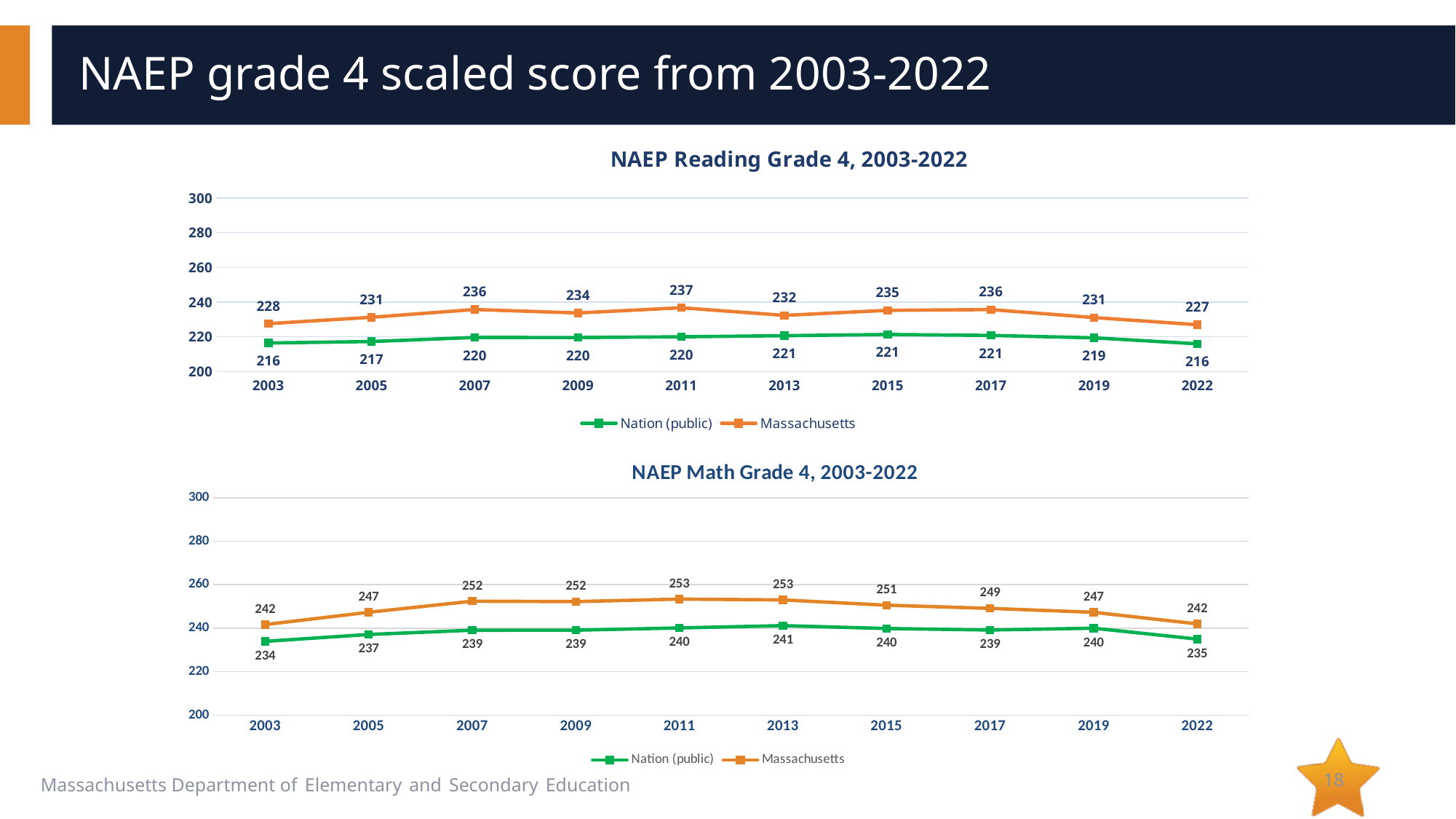
How many years are plotted on the x axis of the NAEP Math Grade 4 chart? 10 How many series does the legend of the NAEP Reading Grade 4 chart list? 2 In the NAEP Math Grade 4 chart, what was the Nation (public) score in 2013? 241 In the NAEP Math Grade 4 chart, in which year was the Nation (public) score lowest? 2003 In the NAEP Reading Grade 4 chart, which series had the higher score in 2019, Nation (public) or Massachusetts? Massachusetts In the NAEP Reading Grade 4 chart, what was the Massachusetts score in 2011? 237 In the NAEP Reading Grade 4 chart, what was the Nation (public) score in 2022? 216 In the NAEP Reading Grade 4 chart, in which year was the Massachusetts score highest? 2011 What type of chart is the NAEP Math Grade 4 chart? Line chart In the NAEP Reading Grade 4 chart, what is the difference between the Massachusetts score in 2017 and in 2022? 9 In the NAEP Math Grade 4 chart, what is the difference between the Massachusetts and Nation (public) scores in 2022? 7 In the NAEP Math Grade 4 chart, what was the Massachusetts score in 2005? 247